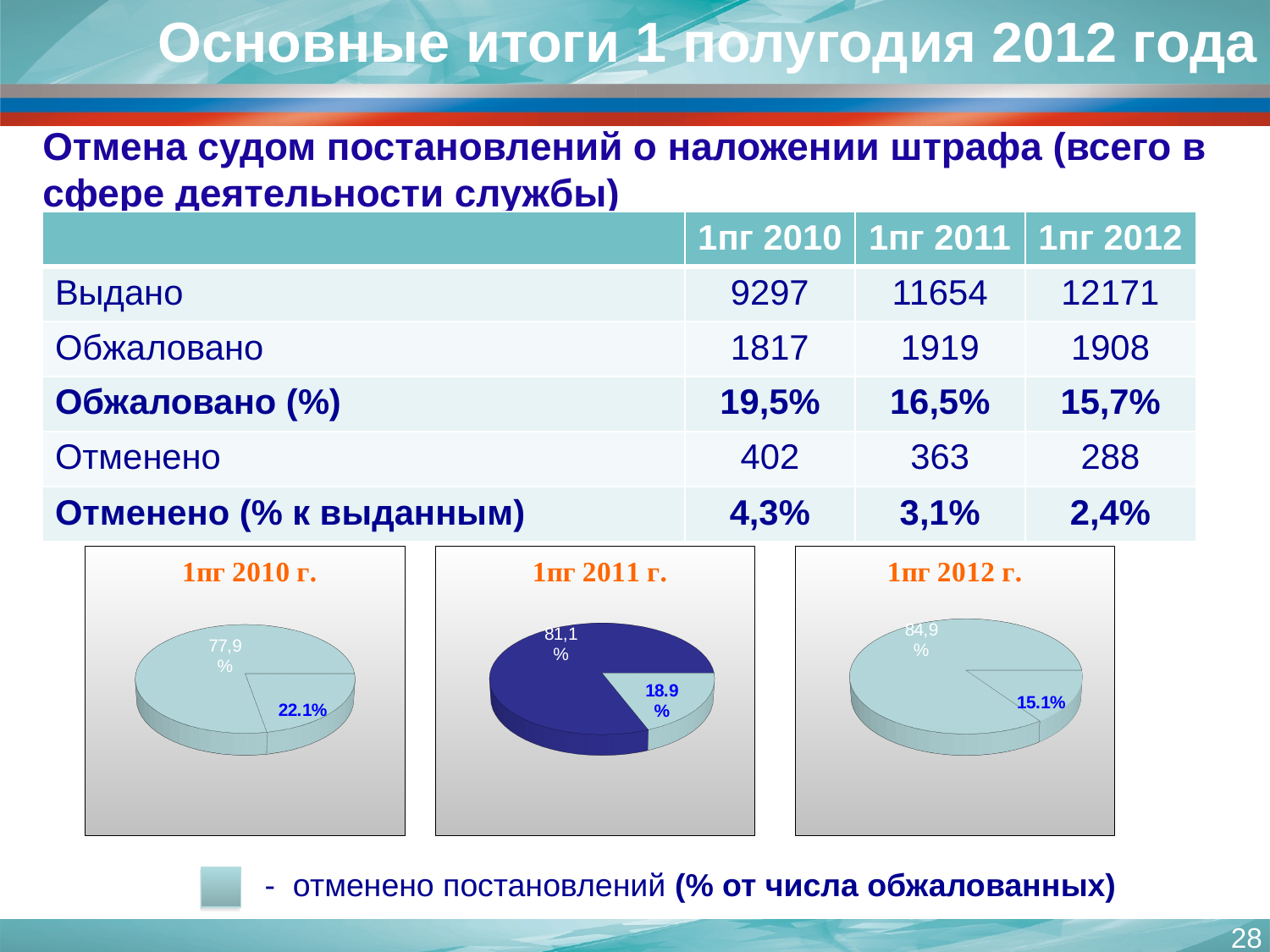
In the "1пг 2012 г." pie chart, what is the value of the smaller slice? 15.1% How many pie charts are shown on the slide? 3 Which pie chart has the smallest small slice: "1пг 2010 г.", "1пг 2011 г." or "1пг 2012 г."? 1пг 2012 г. Which pie chart has the largest small slice: "1пг 2010 г.", "1пг 2011 г." or "1пг 2012 г."? 1пг 2010 г. How many slices does the "1пг 2012 г." pie chart have? 2 What kind of chart is used for "1пг 2010 г."? pie chart In the "1пг 2011 г." pie chart, what is the value of the larger slice? 81,1 % In the "1пг 2010 г." pie chart, what is the value of the larger slice? 77,9 % In the "1пг 2011 г." pie chart, what is the value of the smaller slice? 18.9 % In the "1пг 2010 г." pie chart, what is the value of the smaller slice? 22.1% Is the smaller slice in the "1пг 2011 г." pie chart larger or smaller than the smaller slice in the "1пг 2012 г." pie chart? larger In the "1пг 2012 г." pie chart, what is the value of the larger slice? 84,9 %